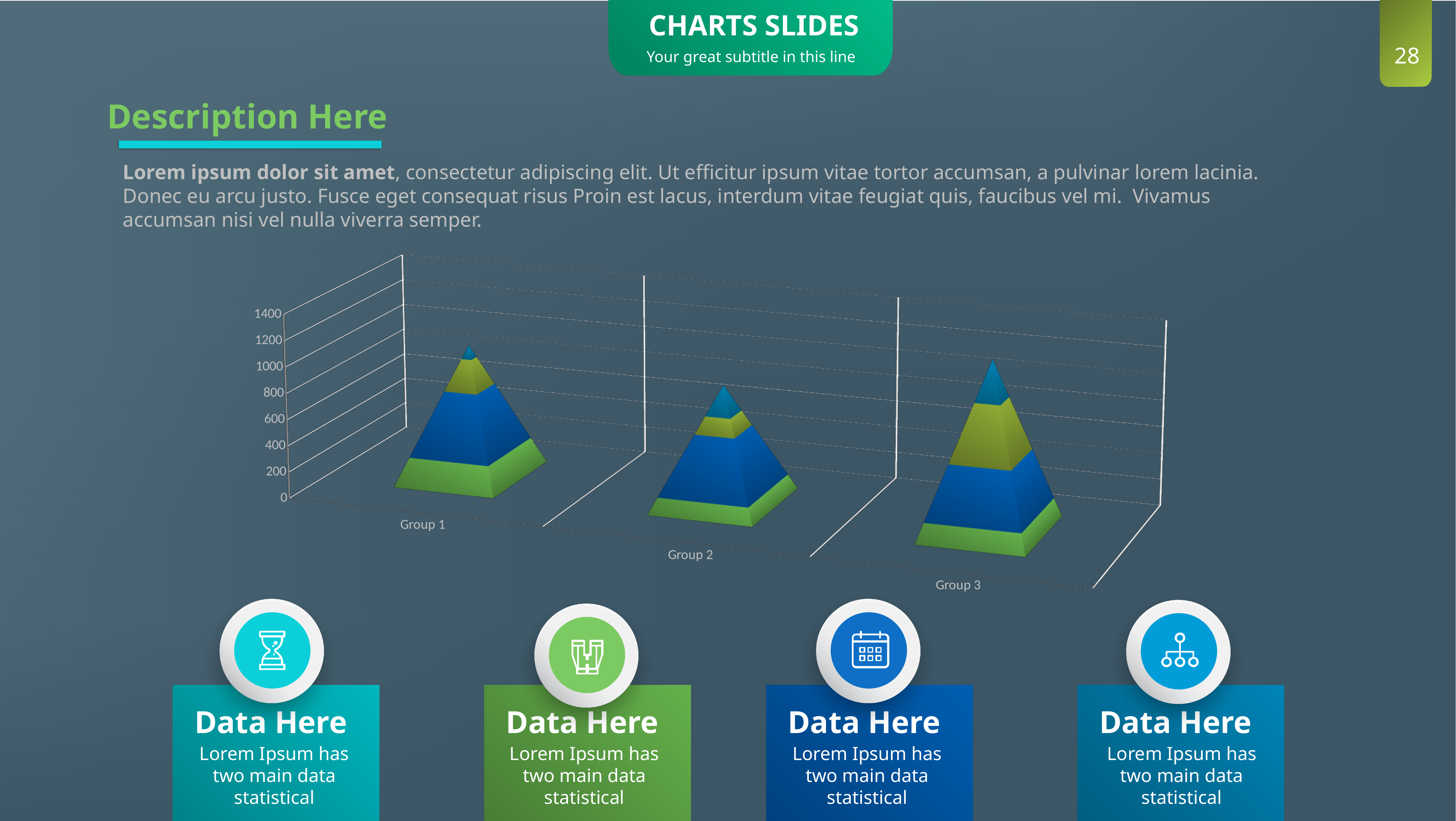
Which group has the shortest stacked bar on the chart? Group 2 What is the label of the first category on the chart's x axis? Group 1 Is the total value for Group 2 greater or less than 1400? less Is the total value for Group 1 greater or less than 400? greater Which has the taller stacked bar, Group 3 or Group 2? Group 3 Which group has the tallest stacked bar on the chart? Group 3 How many groups (categories) are plotted on the chart? 3 What is the highest value shown on the chart's vertical axis? 1400 Is the total value for Group 3 greater or less than 600? greater What kind of chart is shown on the slide? bar chart